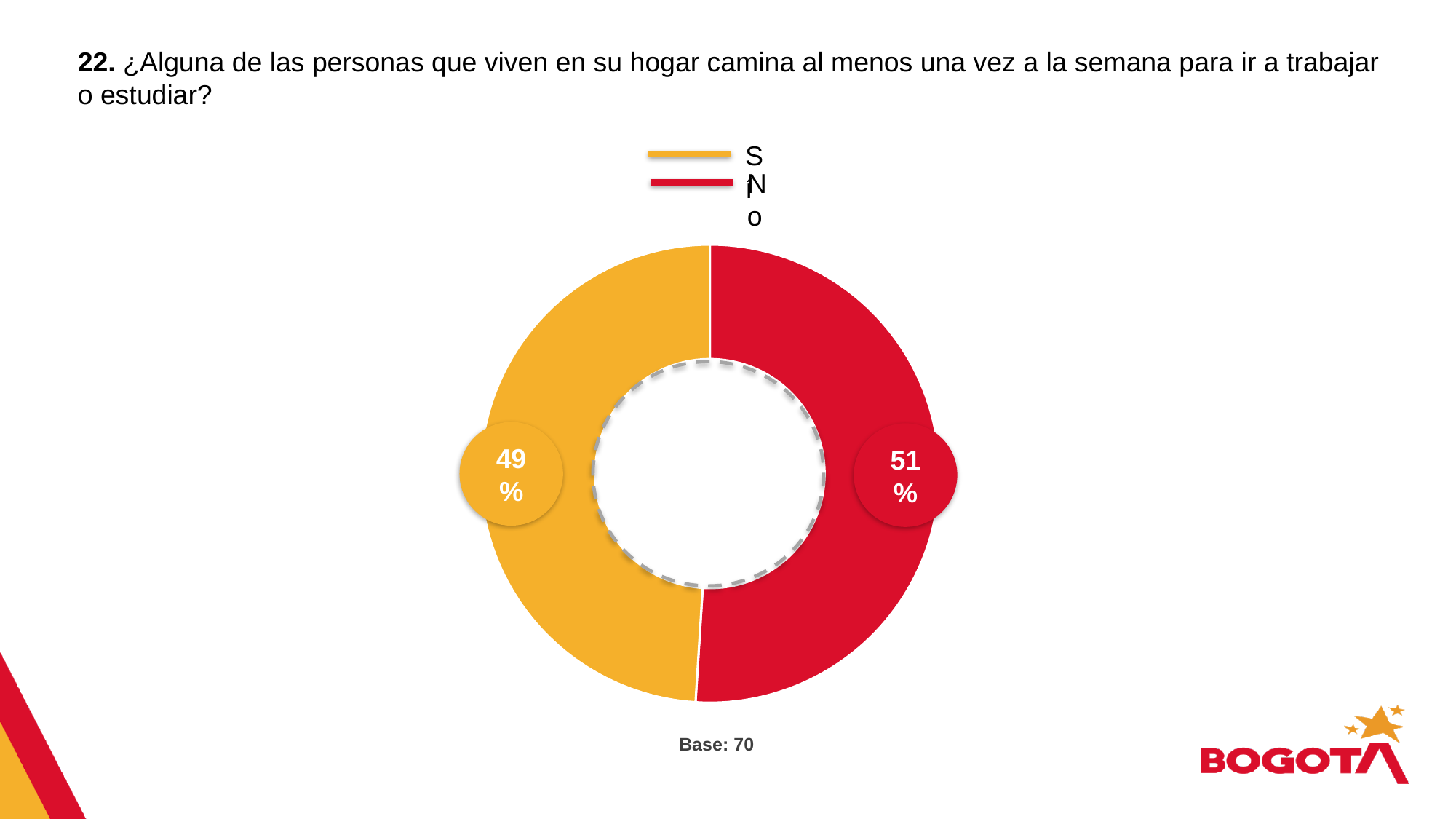
What is the total of the two slices shown in the chart? 100% What colour represents the "No" response in the chart? Red Which response has the largest share in the chart? No What percentage of respondents answered "No"? 51% Which response has the larger share, "Sí" or "No"? No What is the base (number of respondents) stated below the chart? 70 How many categories are shown in the chart? 2 What percentage of respondents answered "Sí"? 49% What is the difference in percentage points between the "No" and "Sí" shares? 2 How many entries does the legend list? 2 Which response has the smallest share in the chart? Sí What kind of chart is shown on the slide? Donut (pie) chart